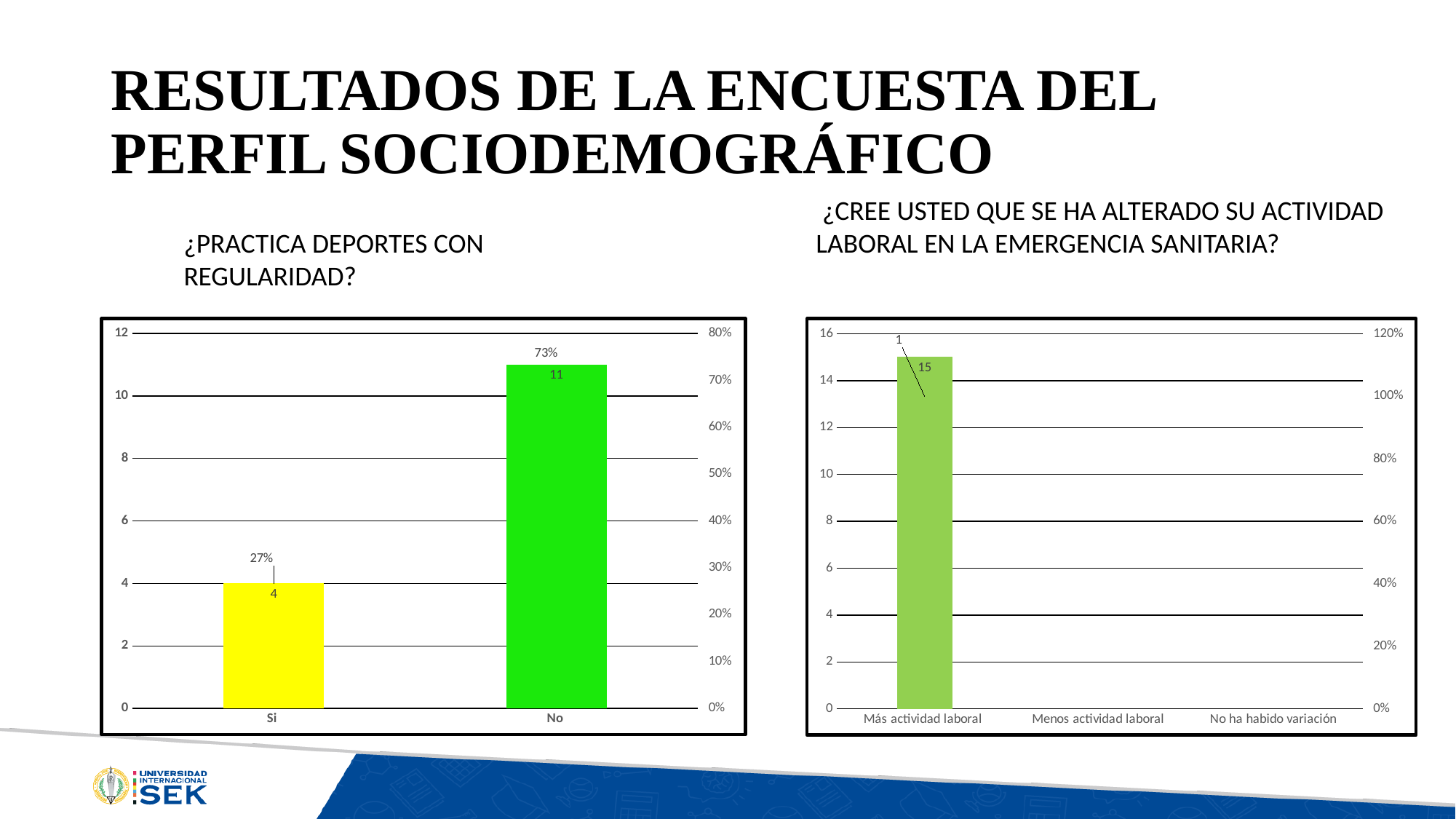
In the chart titled "¿PRACTICA DEPORTES CON REGULARIDAD?", what colour is the bar for "Si"? Yellow In the chart titled "¿PRACTICA DEPORTES CON REGULARIDAD?", what is the count for "No"? 11 In the chart titled "¿PRACTICA DEPORTES CON REGULARIDAD?", which category has the higher count? No In the chart titled "¿CREE USTED QUE SE HA ALTERADO SU ACTIVIDAD LABORAL EN LA EMERGENCIA SANITARIA?", how many categories are shown on the x axis? 3 In the chart titled "¿PRACTICA DEPORTES CON REGULARIDAD?", what is the count for "Si"? 4 In the chart titled "¿PRACTICA DEPORTES CON REGULARIDAD?", what percentage is shown for "Si"? 27% In the chart titled "¿PRACTICA DEPORTES CON REGULARIDAD?", what is the total of the counts for "Si" and "No"? 15 What kind of chart is the one titled "¿PRACTICA DEPORTES CON REGULARIDAD?"? Bar chart In the chart titled "¿CREE USTED QUE SE HA ALTERADO SU ACTIVIDAD LABORAL EN LA EMERGENCIA SANITARIA?", which category has the highest value? Más actividad laboral In the chart titled "¿PRACTICA DEPORTES CON REGULARIDAD?", what is the difference between the counts for "No" and "Si"? 7 In the chart titled "¿PRACTICA DEPORTES CON REGULARIDAD?", what percentage is shown for "No"? 73% In the chart titled "¿CREE USTED QUE SE HA ALTERADO SU ACTIVIDAD LABORAL EN LA EMERGENCIA SANITARIA?", what is the count for "Más actividad laboral"? 15